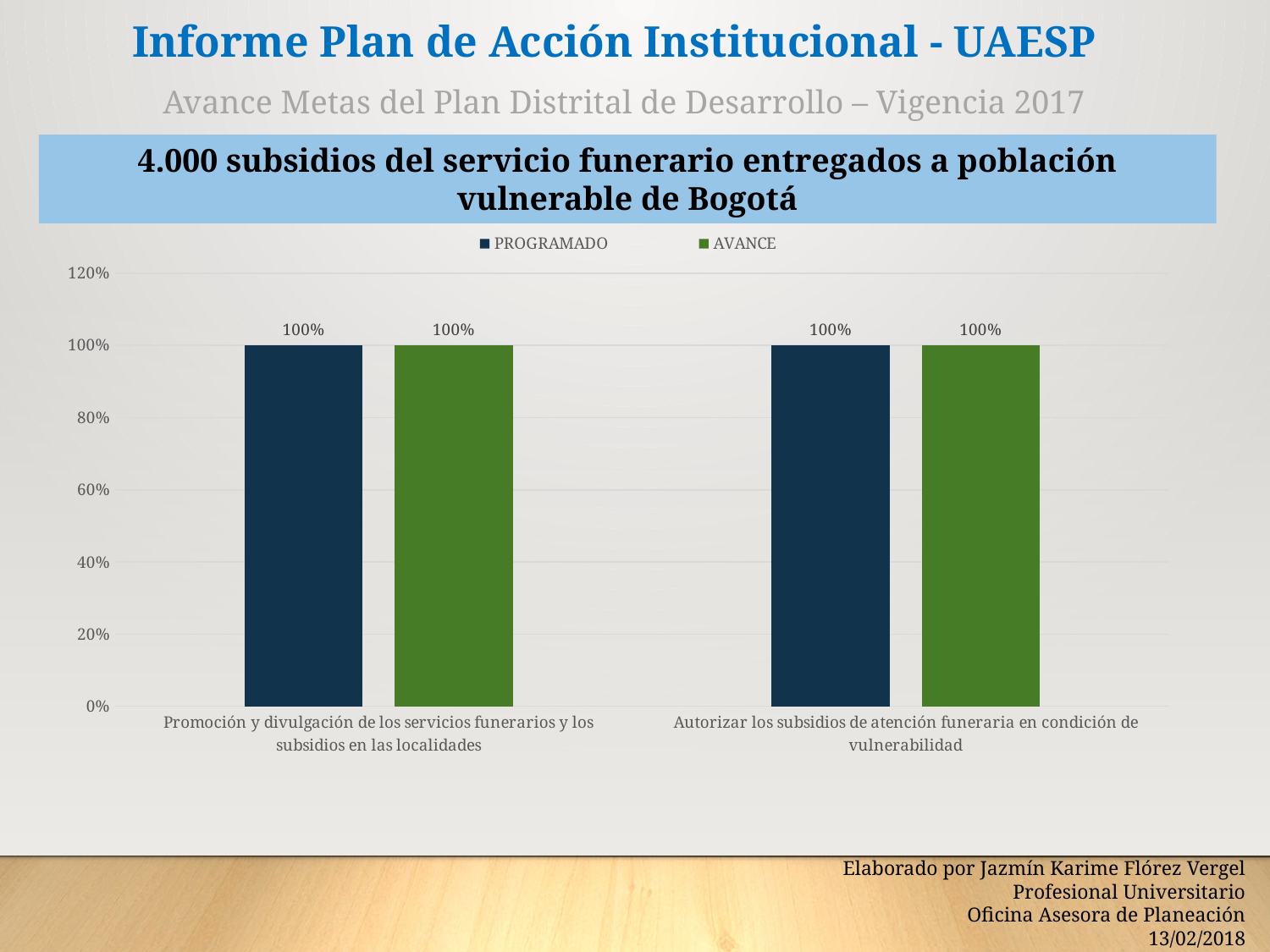
How many categories are shown on the x axis? 2 Is the AVANCE value for "Promoción y divulgación de los servicios funerarios y los subsidios en las localidades" greater or less than 80%? greater What is the AVANCE value for "Promoción y divulgación de los servicios funerarios y los subsidios en las localidades"? 100% How many series does the legend list? 2 What is the PROGRAMADO value for "Promoción y divulgación de los servicios funerarios y los subsidios en las localidades"? 100% What is the highest value shown on the vertical axis? 120% What is the difference between the PROGRAMADO and AVANCE values for "Autorizar los subsidios de atención funeraria en condición de vulnerabilidad"? 0% What colour are the AVANCE bars? Green What is the PROGRAMADO value for "Autorizar los subsidios de atención funeraria en condición de vulnerabilidad"? 100% What are the two series named in the legend? PROGRAMADO and AVANCE What is the AVANCE value for "Autorizar los subsidios de atención funeraria en condición de vulnerabilidad"? 100% What type of chart is shown on the slide? Bar chart